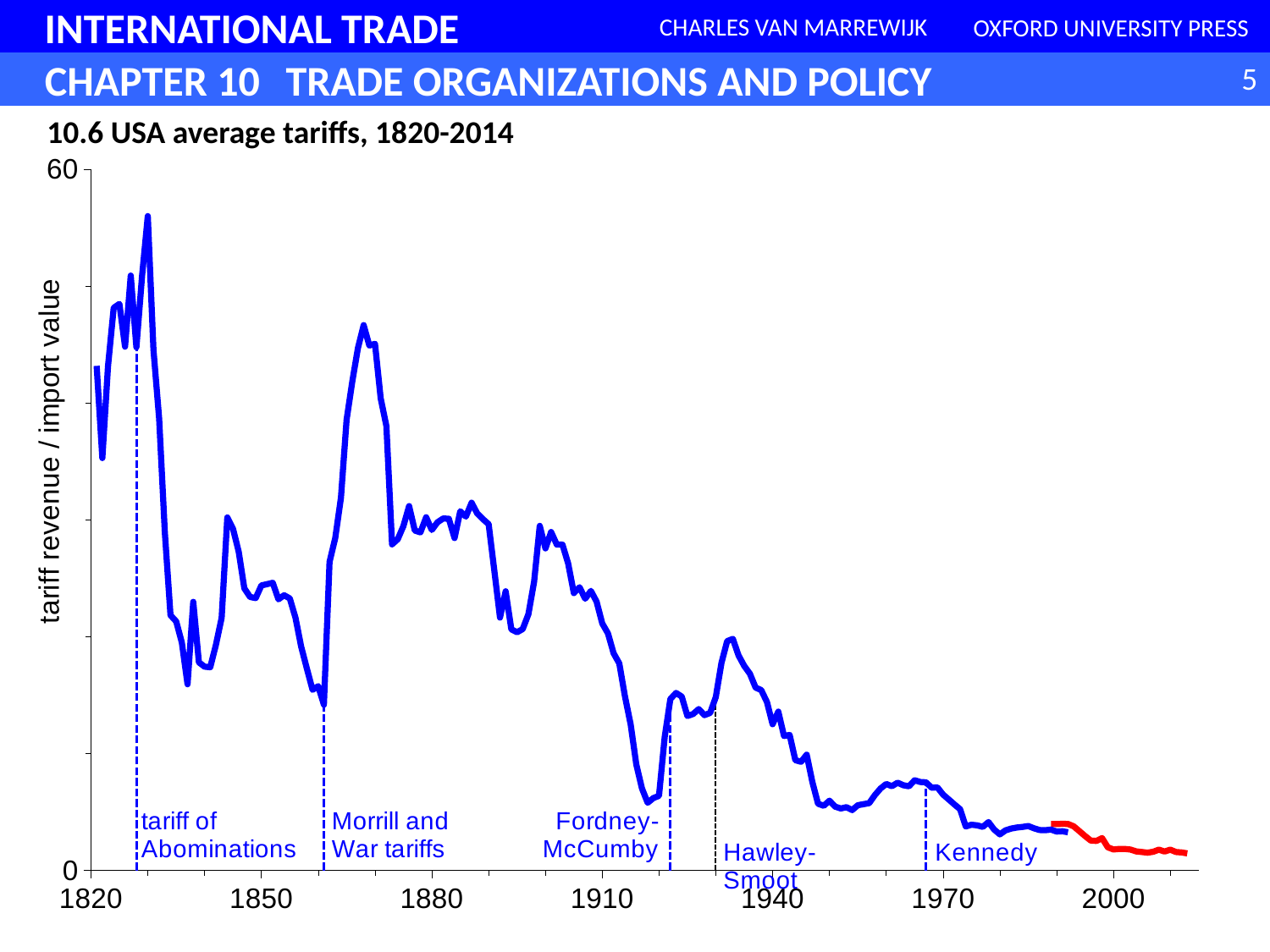
Does the series rise or fall between the Kennedy line and 2014? fall What is the title of the chart? 10.6 USA average tariffs, 1820-2014 Which is larger: the value at the Hawley-Smoot line or the value at the Kennedy line? the value at the Hawley-Smoot line Near which labeled tariff event does the series reach its highest value? tariff of Abominations What colour is the final segment of the line, after about 1990? red Which is larger: the peak near the tariff of Abominations or the peak around 1870? the peak near the tariff of Abominations Which is larger: the value around 1830 or the value around 2000? the value around 1830 Is the value of the series in 2014 greater or less than 60? less How many tariff events are labeled with dashed lines on the chart? 5 Is the highest value of the series greater or less than 60? less Overall, does the tariff revenue / import value series rise or fall from 1820 to 2014? fall What kind of chart is shown on the slide? line chart